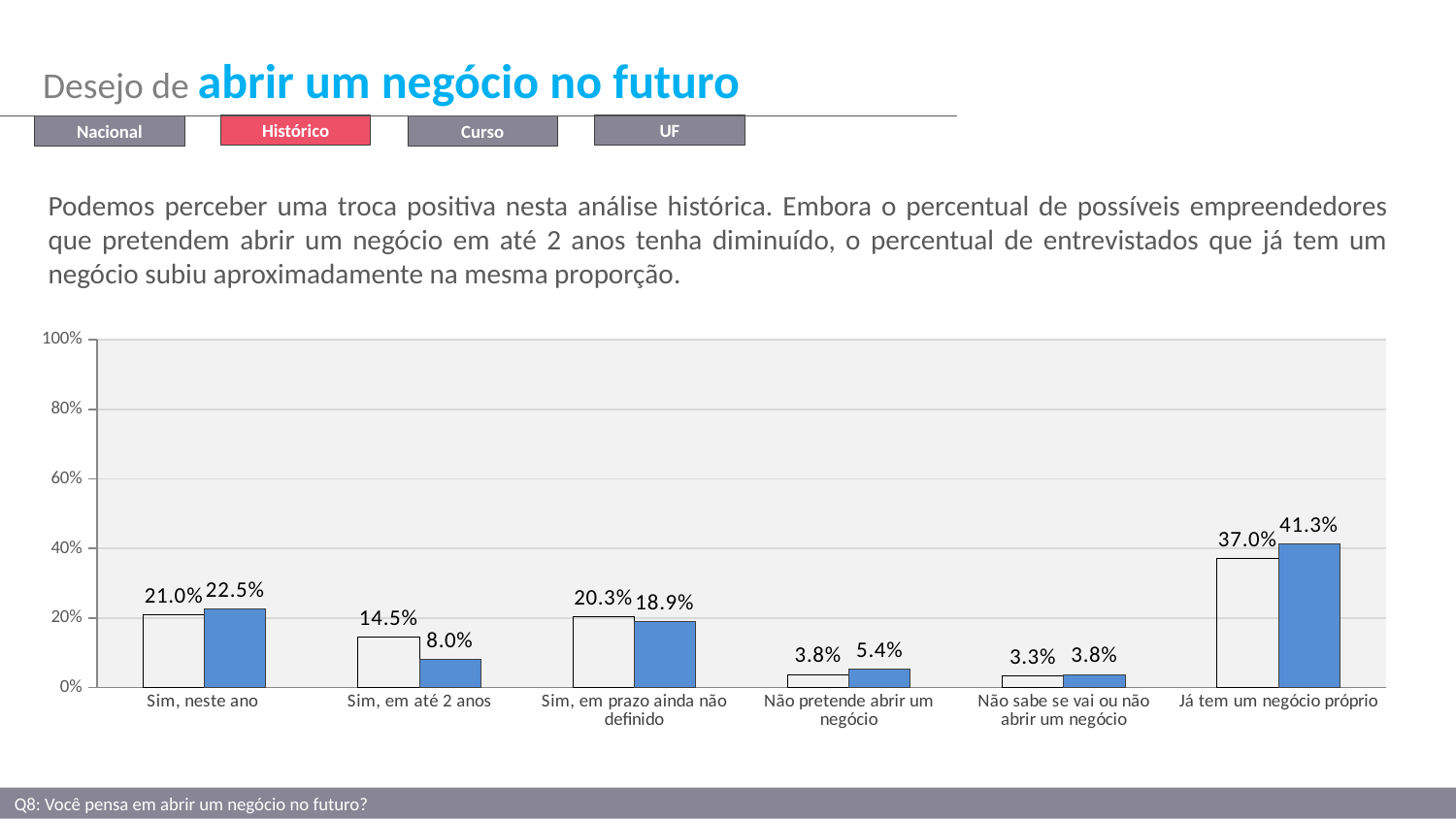
How many categories are shown on the x axis of the chart? 6 Is the value of the white bar for "Já tem um negócio próprio" greater or less than 40%? less What kind of chart is shown on the slide? bar chart Which category has the lowest white bar? Não sabe se vai ou não abrir um negócio What is the value of the white bar for "Sim, em prazo ainda não definido"? 20.3% What is the value of the blue bar for "Já tem um negócio próprio"? 41.3% What is the value of the white bar for "Sim, em até 2 anos"? 14.5% For "Sim, neste ano", which is larger: the white bar or the blue bar? the blue bar Which category has the highest blue bar? Já tem um negócio próprio What is the difference between the blue bar and the white bar for "Sim, em até 2 anos"? 6.5% What is the value of the blue bar for "Não pretende abrir um negócio"? 5.4% What is the difference between the blue bar and the white bar for "Já tem um negócio próprio"? 4.3%